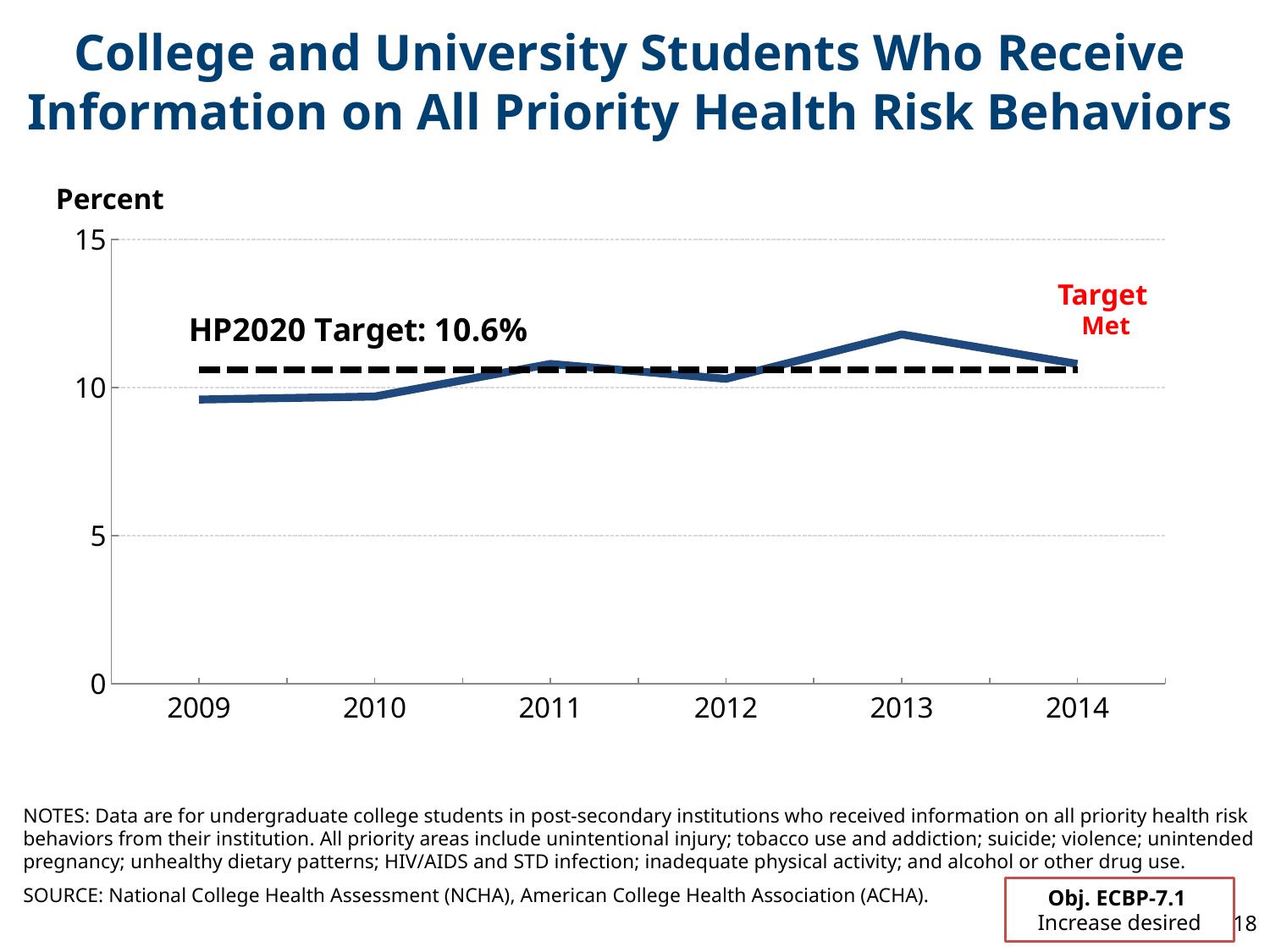
Which year has the highest value on the chart? 2013 Does the value rise or fall from 2013 to 2014? fall Is the value for 2013 greater or less than 10? greater Which year has the larger value, 2012 or 2013? 2013 Is the value for 2009 greater or less than 10? less How many years are plotted along the x axis? 6 What is the label on the y axis of the chart? Percent Is the value for 2013 greater or less than 15? less What is the HP2020 target value shown on the chart? 10.6% What kind of chart is shown on the slide? line chart Does the value rise or fall from 2012 to 2013? rise What does the red annotation at the right of the chart say? Target Met